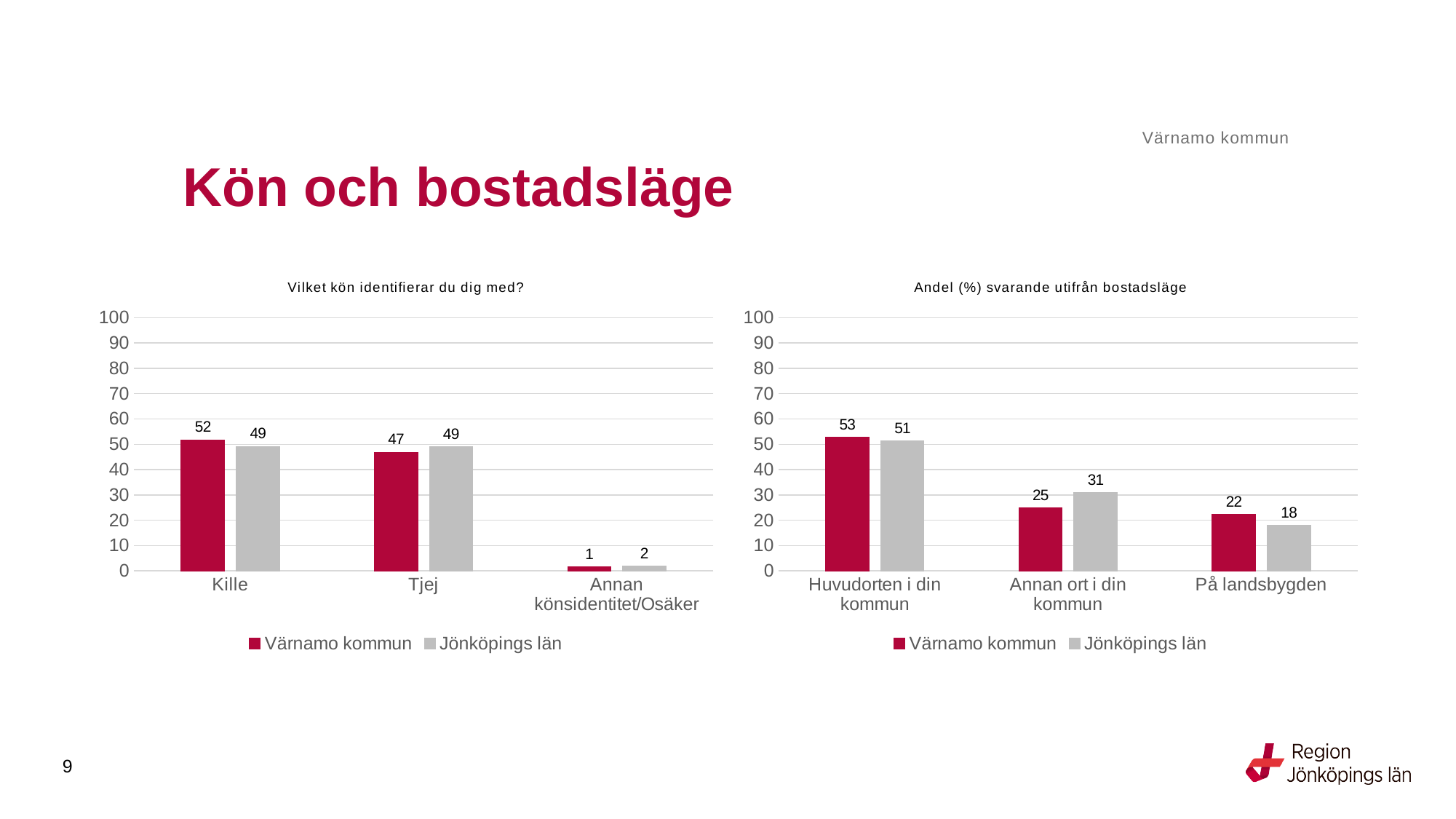
In the chart titled "Andel (%) svarande utifrån bostadsläge", which is larger for Annan ort i din kommun: Värnamo kommun or Jönköpings län? Jönköpings län In the chart titled "Andel (%) svarande utifrån bostadsläge", what is the value for Jönköpings län in the På landsbygden category? 18 In the chart titled "Vilket kön identifierar du dig med?", which category has the lowest value for Värnamo kommun? Annan könsidentitet/Osäker In the chart titled "Vilket kön identifierar du dig med?", what is the value for Värnamo kommun in the Kille category? 52 In the chart titled "Vilket kön identifierar du dig med?", how many categories are shown on the x axis? 3 What kind of chart is the chart titled "Vilket kön identifierar du dig med?"? Bar chart In the chart titled "Vilket kön identifierar du dig med?", what is the value for Jönköpings län in the Tjej category? 49 In the chart titled "Andel (%) svarande utifrån bostadsläge", what is the difference between the Jönköpings län and Värnamo kommun values for Annan ort i din kommun? 6 In the chart titled "Andel (%) svarande utifrån bostadsläge", how many series does the legend list? 2 In the chart titled "Andel (%) svarande utifrån bostadsläge", which category has the highest value for Jönköpings län? Huvudorten i din kommun In the chart titled "Andel (%) svarande utifrån bostadsläge", what is the value for Värnamo kommun in the Huvudorten i din kommun category? 53 In the chart titled "Vilket kön identifierar du dig med?", what is the difference between the Värnamo kommun and Jönköpings län values for Kille? 3